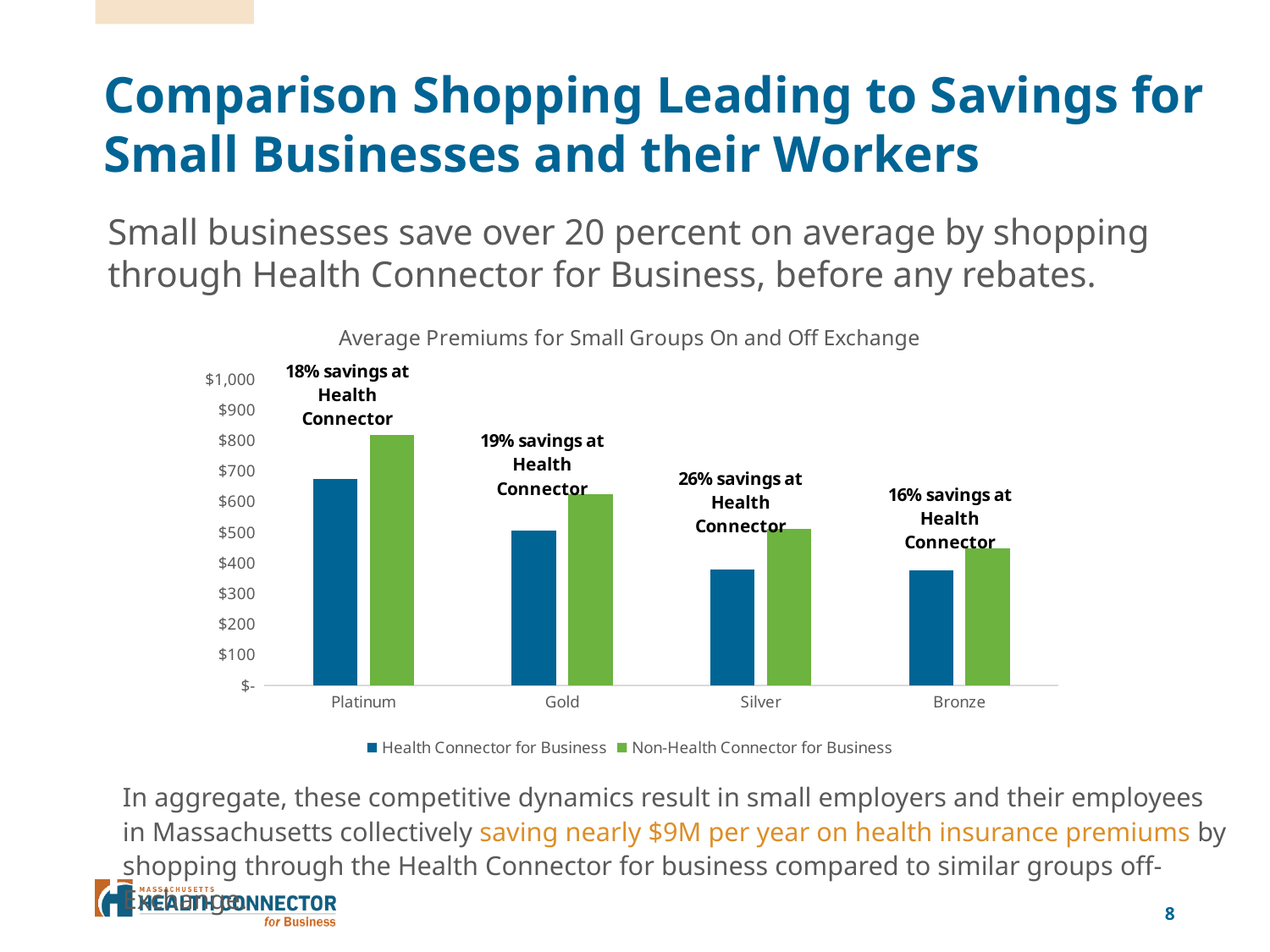
How many series does the chart's legend list? 2 Is the Health Connector for Business premium for Platinum greater or less than $600? greater Do the Non-Health Connector for Business premiums rise or fall moving from Platinum to Bronze along the x axis? fall According to the chart annotation, what is the savings at Health Connector for the Bronze tier? 16% savings at Health Connector Which tier has the highest Non-Health Connector for Business premium in the chart? Platinum According to the chart annotation, what is the savings at Health Connector for the Silver tier? 26% savings at Health Connector What kind of chart is shown on the slide? Bar chart How many metal tier categories are shown on the x axis of the chart? 4 Which tier shows the highest savings percentage at Health Connector in the chart? Silver Is the Non-Health Connector for Business premium for Bronze greater or less than $500? less What is the title of the chart? Average Premiums for Small Groups On and Off Exchange Which tier shows the lowest savings percentage at Health Connector in the chart? Bronze